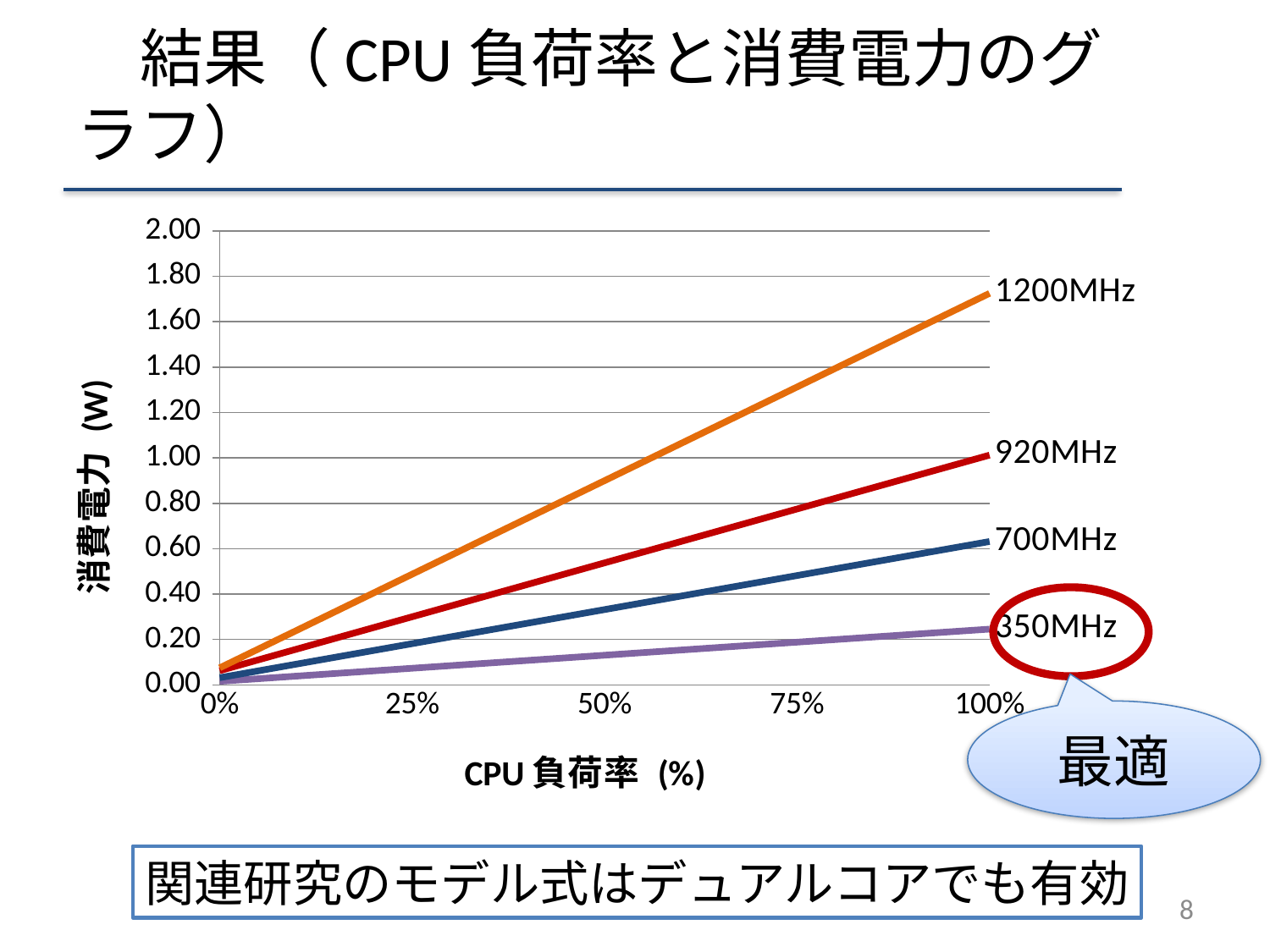
Which series has the lowest power consumption at 100% CPU load? 350MHz Is the value for 1200MHz at 100% CPU load greater or less than 1.60? greater What kind of chart is shown on the slide? line chart Is the value for 920MHz at 50% CPU load greater or less than 0.40? greater Is the value for 700MHz at 100% CPU load greater or less than 0.80? less Does the power consumption for the 1200MHz series rise or fall as CPU load increases from 0% to 100%? rise Which series has the highest power consumption at 100% CPU load? 1200MHz At 100% CPU load, which series has the larger power consumption, 920MHz or 700MHz? 920MHz How many series (frequency lines) are plotted on the chart? 4 What is the title of the vertical axis? 消費電力 (W) Which series is circled and labeled 最適 on the slide? 350MHz